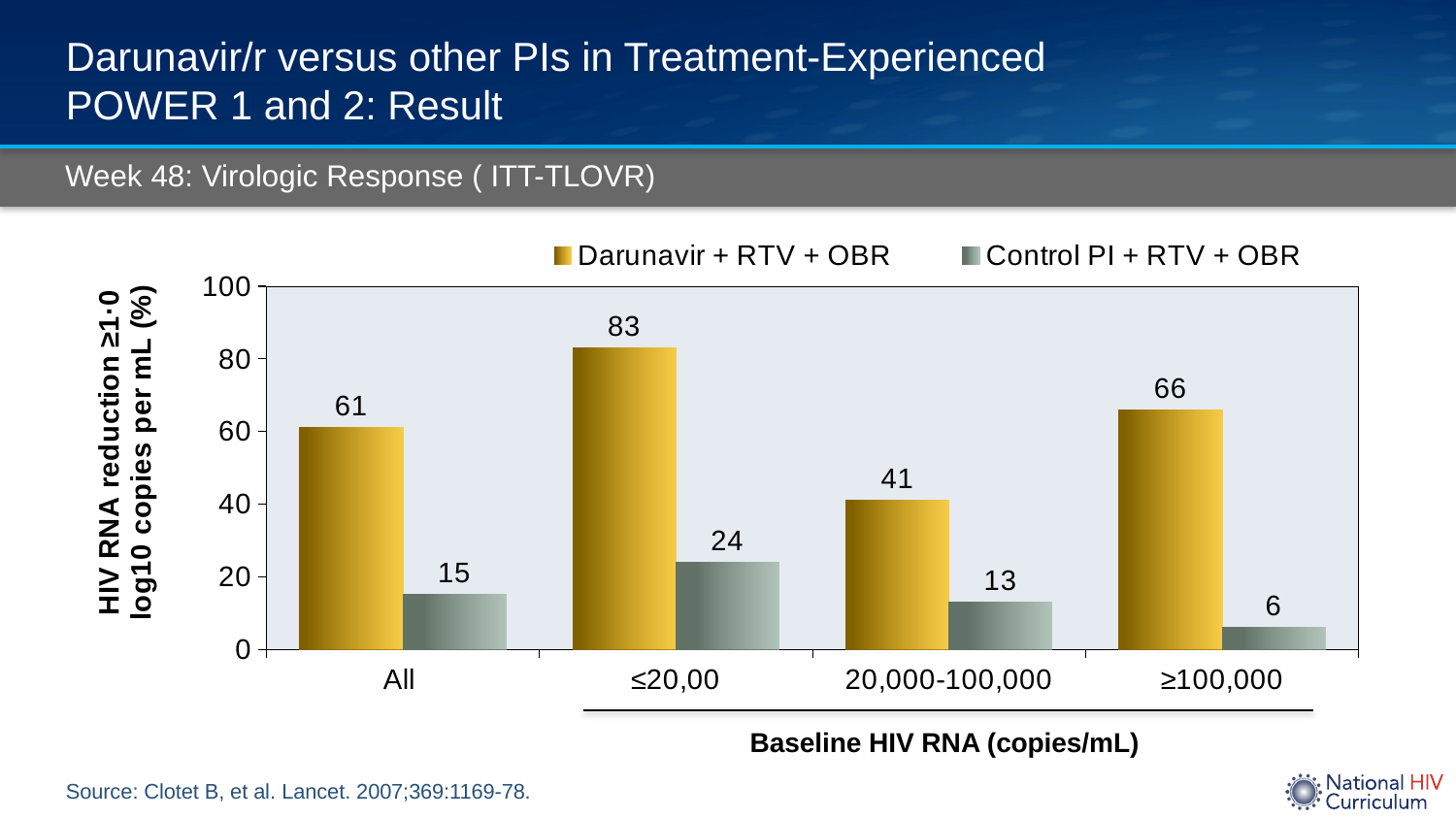
What is the value for Darunavir + RTV + OBR in the All category? 61 How many baseline HIV RNA categories are shown on the x axis? 4 How many series does the legend list? 2 What is the value for Control PI + RTV + OBR in the ≥100,000 category? 6 What kind of chart is shown on the slide? Bar chart What is the value for Control PI + RTV + OBR in the 20,000-100,000 category? 13 Is the Darunavir + RTV + OBR value for 20,000-100,000 greater or less than 60? less Which baseline HIV RNA category has the highest value for Darunavir + RTV + OBR? ≤20,00 Which is larger: the Control PI + RTV + OBR value for All or for ≤20,00? ≤20,00 Which baseline HIV RNA category has the lowest value for Control PI + RTV + OBR? ≥100,000 What is the difference between the Darunavir + RTV + OBR and Control PI + RTV + OBR values in the ≤20,00 category? 59 What is the difference between the Darunavir + RTV + OBR values for ≥100,000 and 20,000-100,000? 25